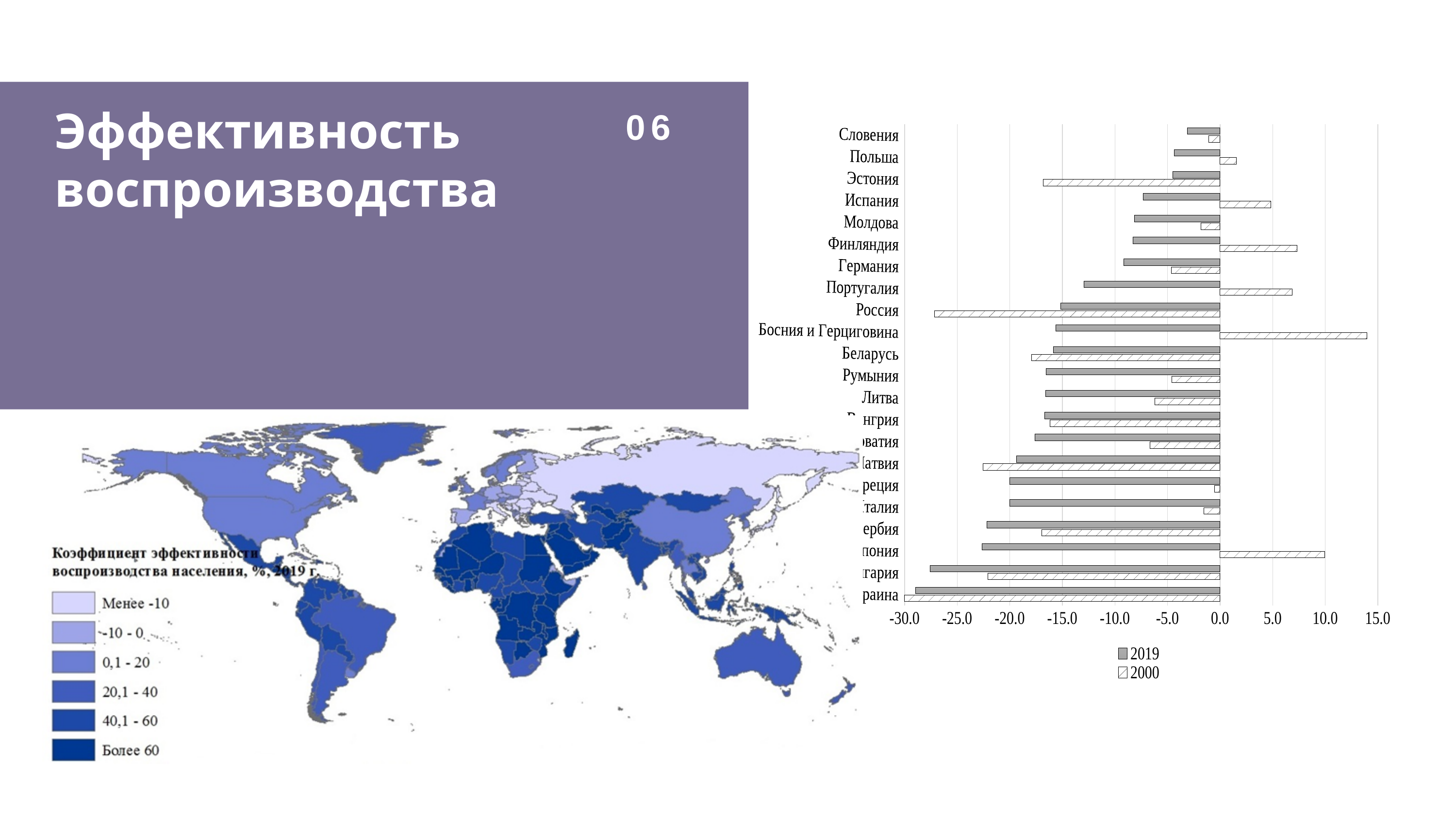
What are the two series named in the legend of the bar chart? 2019 and 2000 In the bar chart, is the 2019 value for Германия greater or less than -5.0? less How many series does the legend of the bar chart list? 2 In the bar chart, is the 2000 value for Россия greater or less than -25.0? less What kind of chart is shown on the right side of the slide? bar chart In the bar chart, is the 2000 value for Босния и Герциговина greater or less than 10.0? greater How many countries are plotted in the bar chart? 22 In the bar chart, which country has the higher 2019 value, Россия or Словения? Словения In the bar chart, which country has the highest value for 2000? Босния и Герциговина